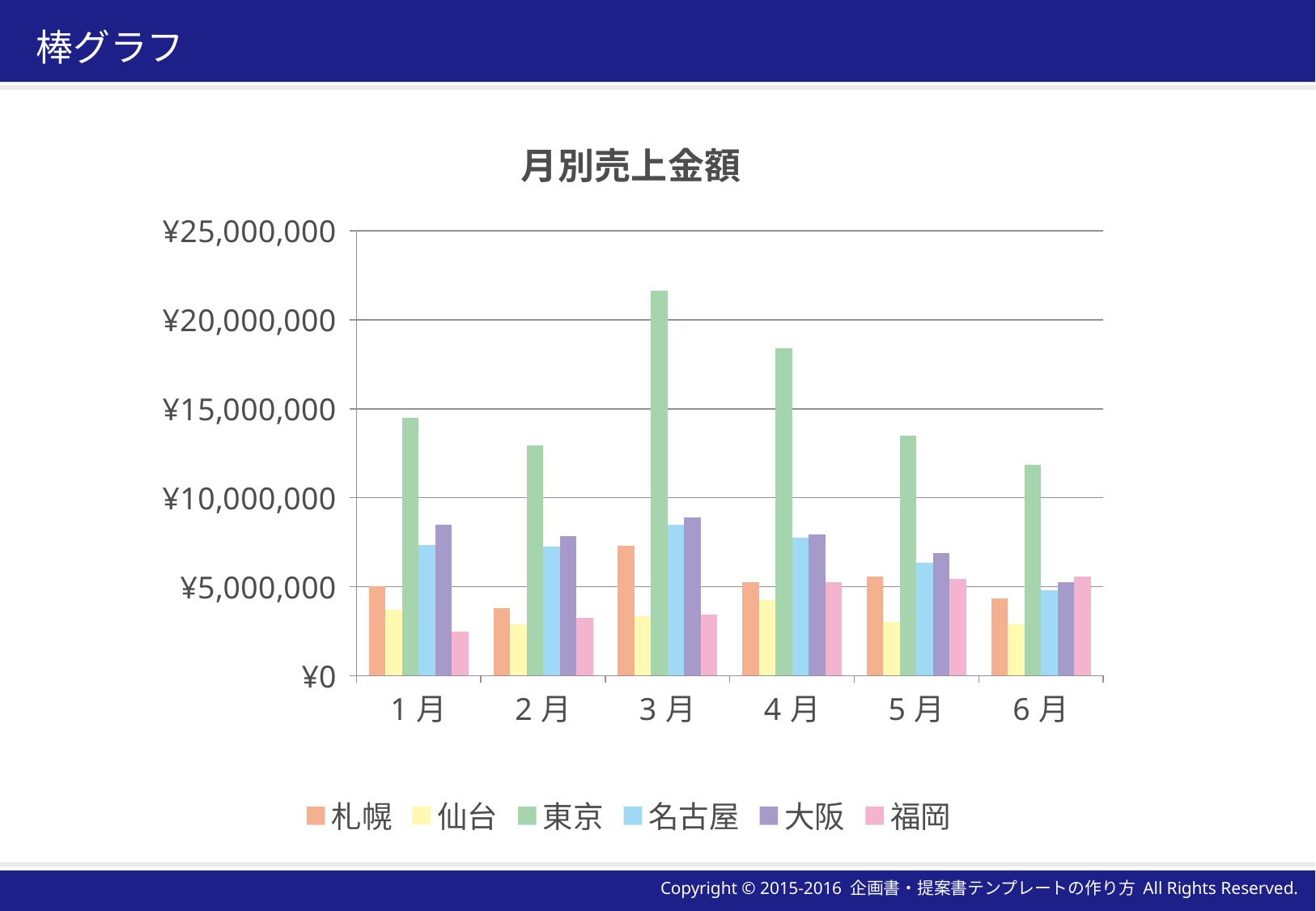
How many months are shown on the x axis? 6 Is the value for 東京 in 4月 greater or less than ¥20,000,000? less What is the title of the chart? 月別売上金額 In which month is the value for 東京 the lowest? 6月 In 1月, which city has the lowest value? 福岡 Is the value for 東京 in 3月 greater or less than ¥20,000,000? greater How many series does the legend list? 6 In 3月, which is larger, the value for 札幌 or the value for 仙台? 札幌 Which colour represents 東京 in the legend? green What kind of chart is shown on the slide? bar chart Is the value for 札幌 in 3月 greater or less than ¥5,000,000? greater In which month is the value for 東京 the highest? 3月